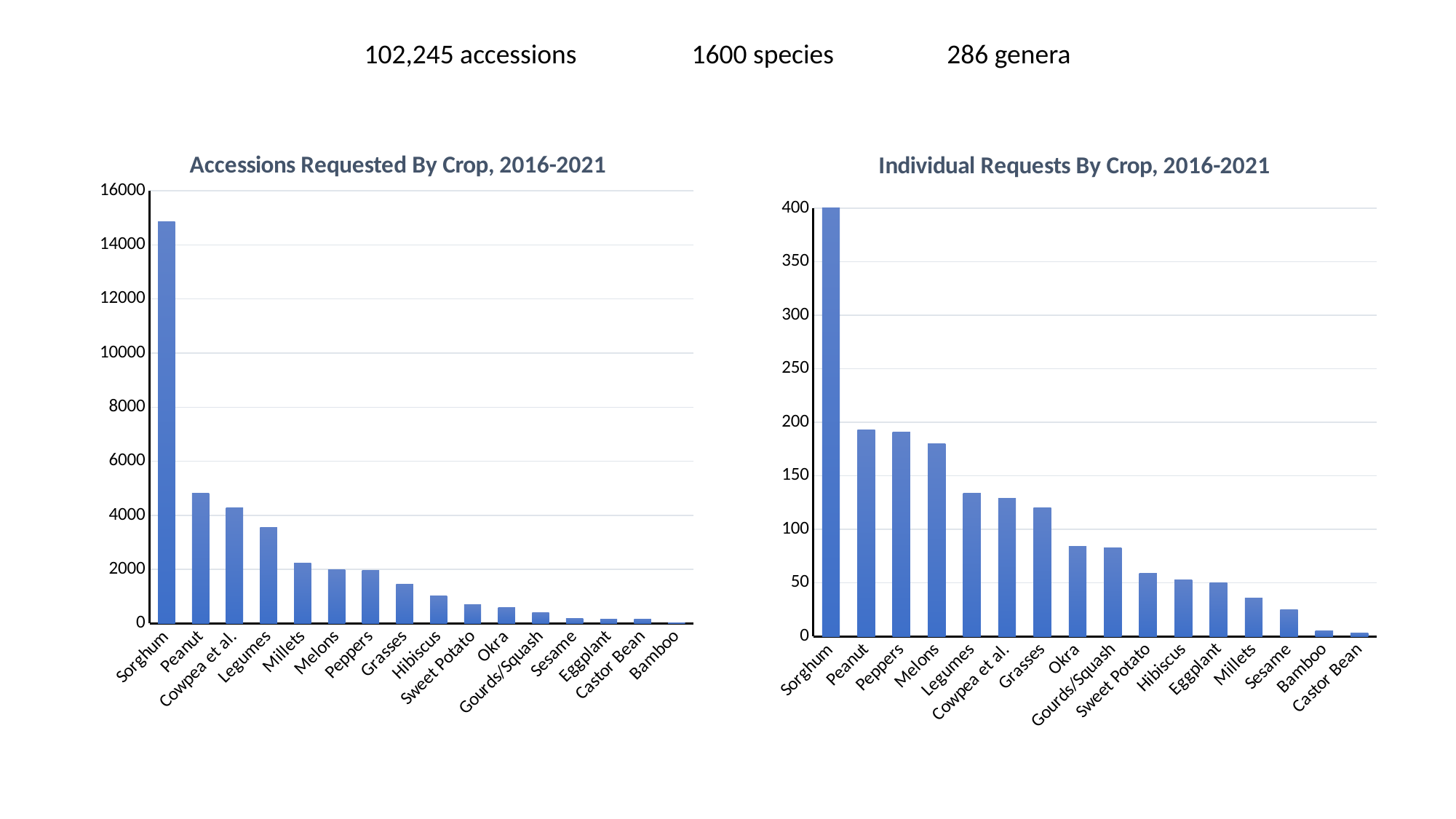
How many crops are shown in "Accessions Requested By Crop, 2016-2021"? 16 In "Accessions Requested By Crop, 2016-2021", which crop has the highest value? Sorghum In "Individual Requests By Crop, 2016-2021", which crop has the lowest value? Castor Bean In "Accessions Requested By Crop, 2016-2021", is the value for Hibiscus greater or less than 2000? less In "Individual Requests By Crop, 2016-2021", which crop has the highest value? Sorghum What kind of chart is "Accessions Requested By Crop, 2016-2021"? bar chart In "Individual Requests By Crop, 2016-2021", is the value for Peanut greater or less than 200? less In "Individual Requests By Crop, 2016-2021", do the values rise or fall from left to right along the x axis? fall In "Accessions Requested By Crop, 2016-2021", which is larger, Peanut or Legumes? Peanut In "Accessions Requested By Crop, 2016-2021", is the value for Sorghum greater or less than 14000? greater In "Accessions Requested By Crop, 2016-2021", which crop has the lowest value? Bamboo